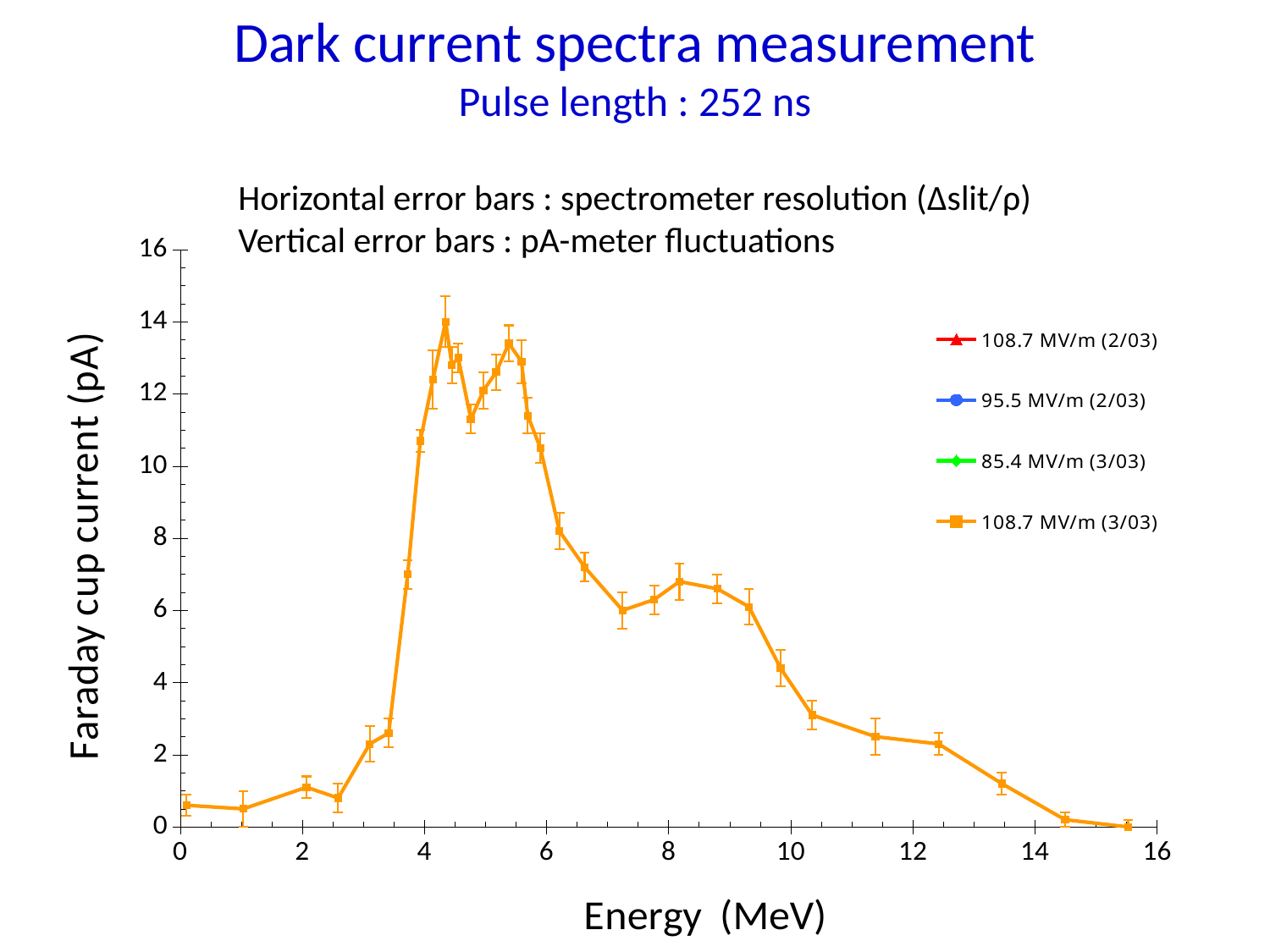
What quantity is plotted on the y axis of the chart? Faraday cup current (pA) Is the highest Faraday cup current on the curve greater or less than 12 pA? greater Is the Faraday cup current at about 14 MeV greater or less than 2 pA? less Is the Faraday cup current at about 8 MeV greater or less than 6 pA? greater What kind of chart is shown on the slide? line chart Which is larger, the Faraday cup current at about 8 MeV or at about 12 MeV? about 8 MeV How many series does the legend list? 4 Between 0 MeV and 4 MeV, does the Faraday cup current rise or fall as energy increases? rise Between 10 MeV and 16 MeV, does the Faraday cup current rise or fall as energy increases? fall What is the title of the chart on the slide? Dark current spectra measurement